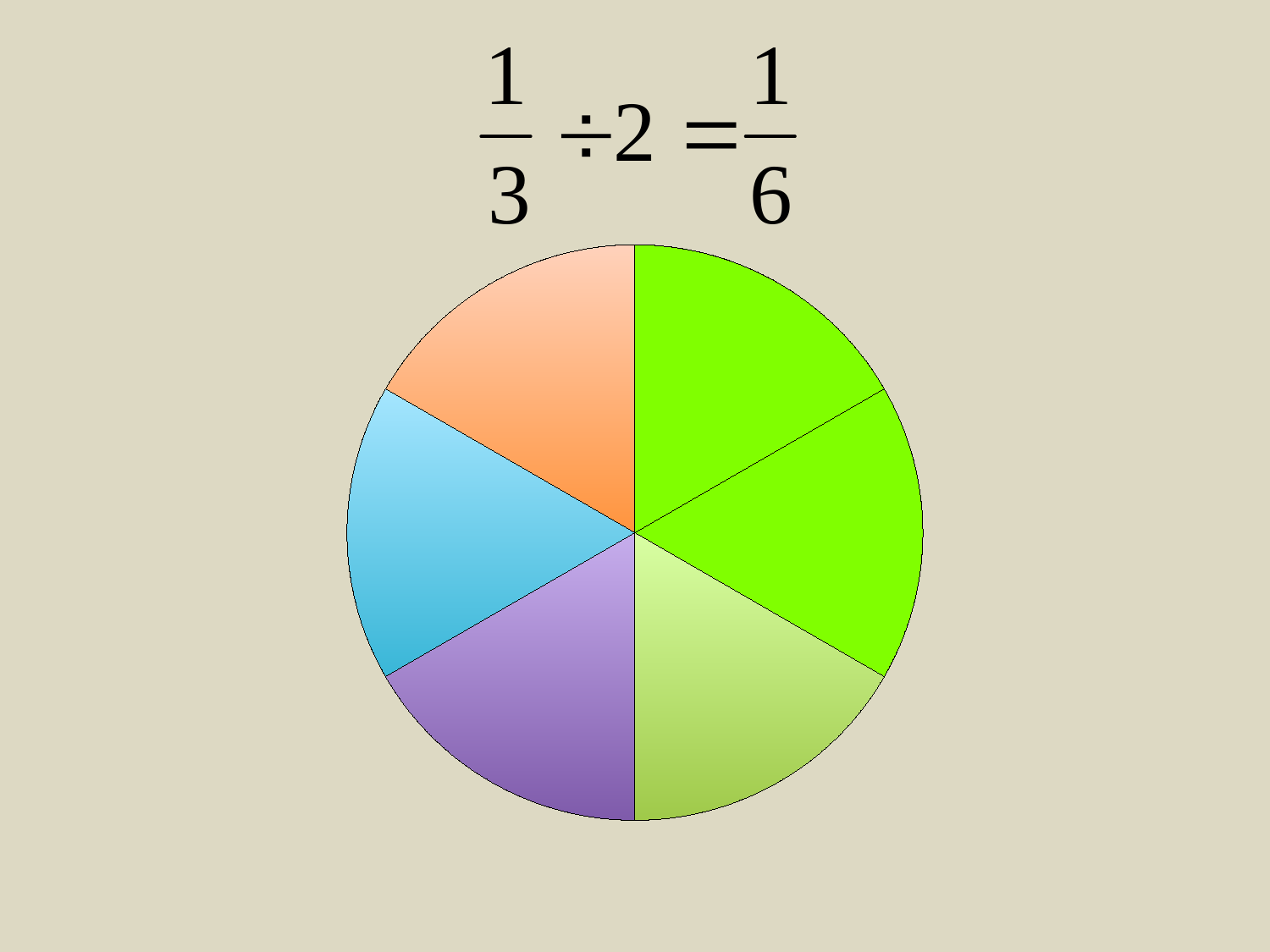
What fraction of the whole pie does a single slice represent, according to the equation above the chart? 1/6 How many slices does the pie chart have? 6 How many slices of the pie chart are coloured bright green? 2 What colour is the slice at the bottom left of the pie chart? purple What kind of chart is shown on the slide? pie chart